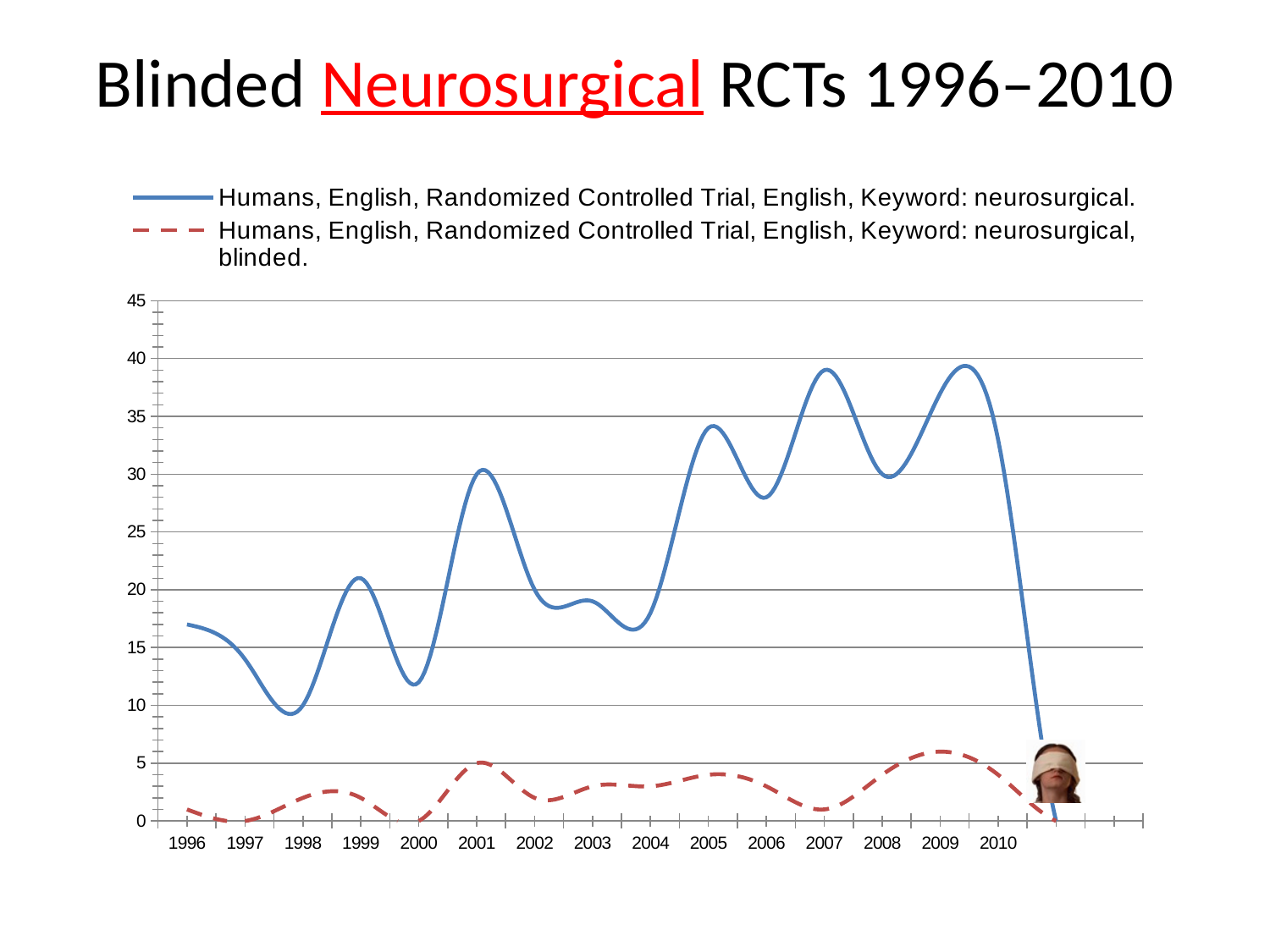
For the solid blue line (neurosurgical), which year has the larger value, 2005 or 2006? 2005 What kind of chart is shown on the slide? line chart For the dashed red line (blinded), which year has the larger value, 2009 or 2007? 2009 Is the value of the solid blue line (neurosurgical) in 2001 greater or less than 25? greater Is the value of the solid blue line (neurosurgical) in 2000 greater or less than 15? less How many years are labeled on the x axis? 15 Is the value of the solid blue line (neurosurgical) in 2007 greater or less than 35? greater What is the title of the slide? Blinded Neurosurgical RCTs 1996–2010 Which series is drawn with a dashed line? Humans, English, Randomized Controlled Trial, English, Keyword: neurosurgical, blinded. Does the solid blue line (neurosurgical) generally rise or fall from 1996 to 2009? rise How many series does the legend list? 2